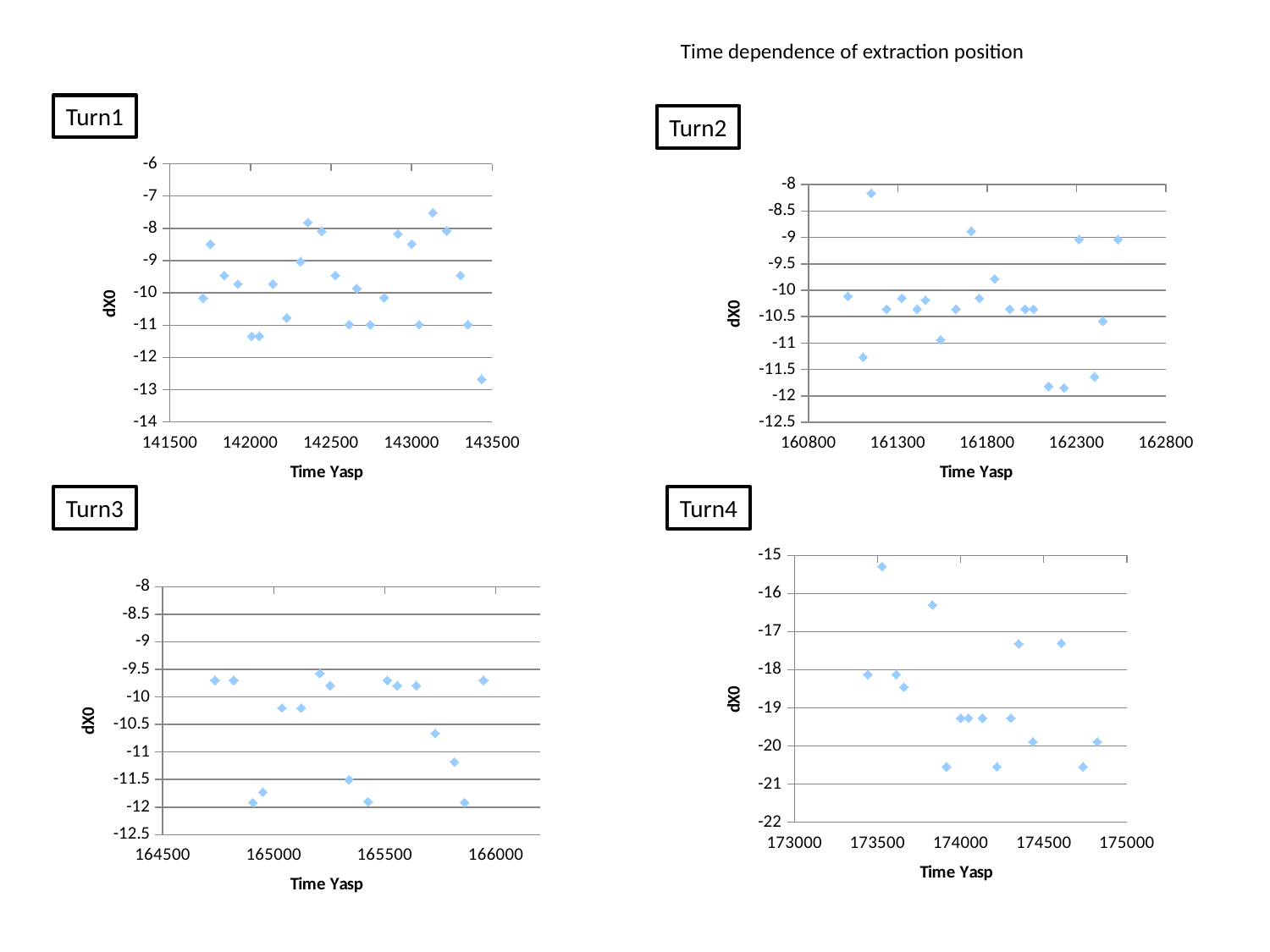
Which of the four charts shows the lowest dX0 values overall? Turn4 In the Turn3 chart, is the lowest plotted dX0 value greater or less than -11.5? less What is the y-axis title of the Turn2 chart? dX0 What is the x-axis title of the Turn3 chart? Time Yasp In the Turn1 chart, is the lowest plotted dX0 value greater or less than -12? less How many charts are shown on the slide? 4 In the Turn2 chart, is the lowest plotted dX0 value greater or less than -11.5? less Are the dX0 values plotted in the Turn4 chart generally higher or lower than those in the Turn1 chart? lower What kind of chart is the Turn1 chart? scatter chart